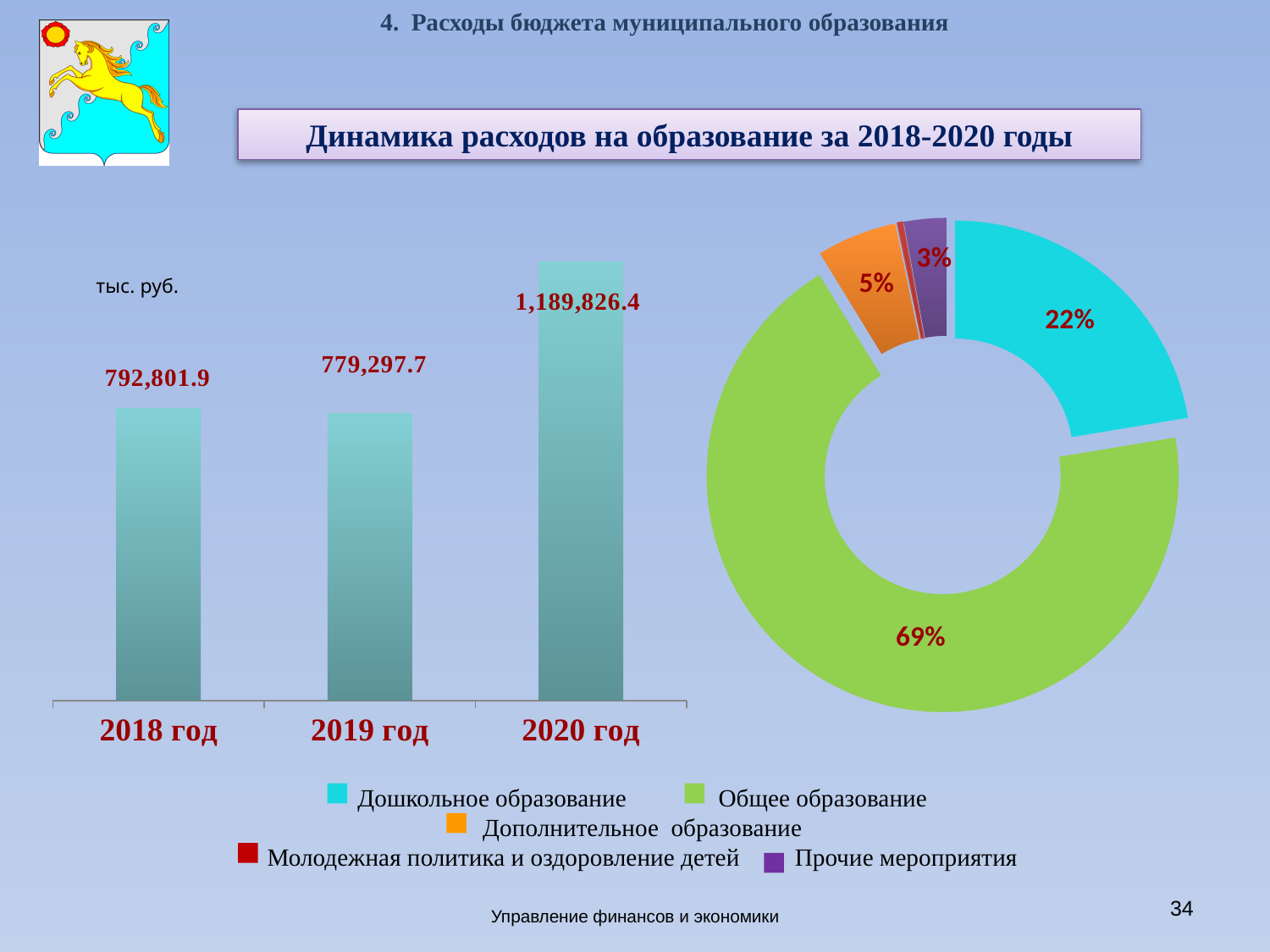
What kind of chart is on the left side of the slide? Bar chart On the doughnut chart on the right, what share does Общее образование have? 69% On the bar chart on the left, how many years are shown? 3 On the doughnut chart on the right, which category has the largest share? Общее образование How many categories does the legend of the doughnut chart list? 5 On the doughnut chart on the right, what share does Дошкольное образование have? 22% On the bar chart on the left, what is the value for 2020 год? 1,189,826.4 On the bar chart on the left, which year has the lowest value? 2019 год On the bar chart on the left, what is the difference between the values for 2020 год and 2019 год? 410,528.7 On the bar chart on the left, what is the value for 2019 год? 779,297.7 On the bar chart on the left, which year has the highest value? 2020 год On the bar chart on the left, what is the value for 2018 год? 792,801.9